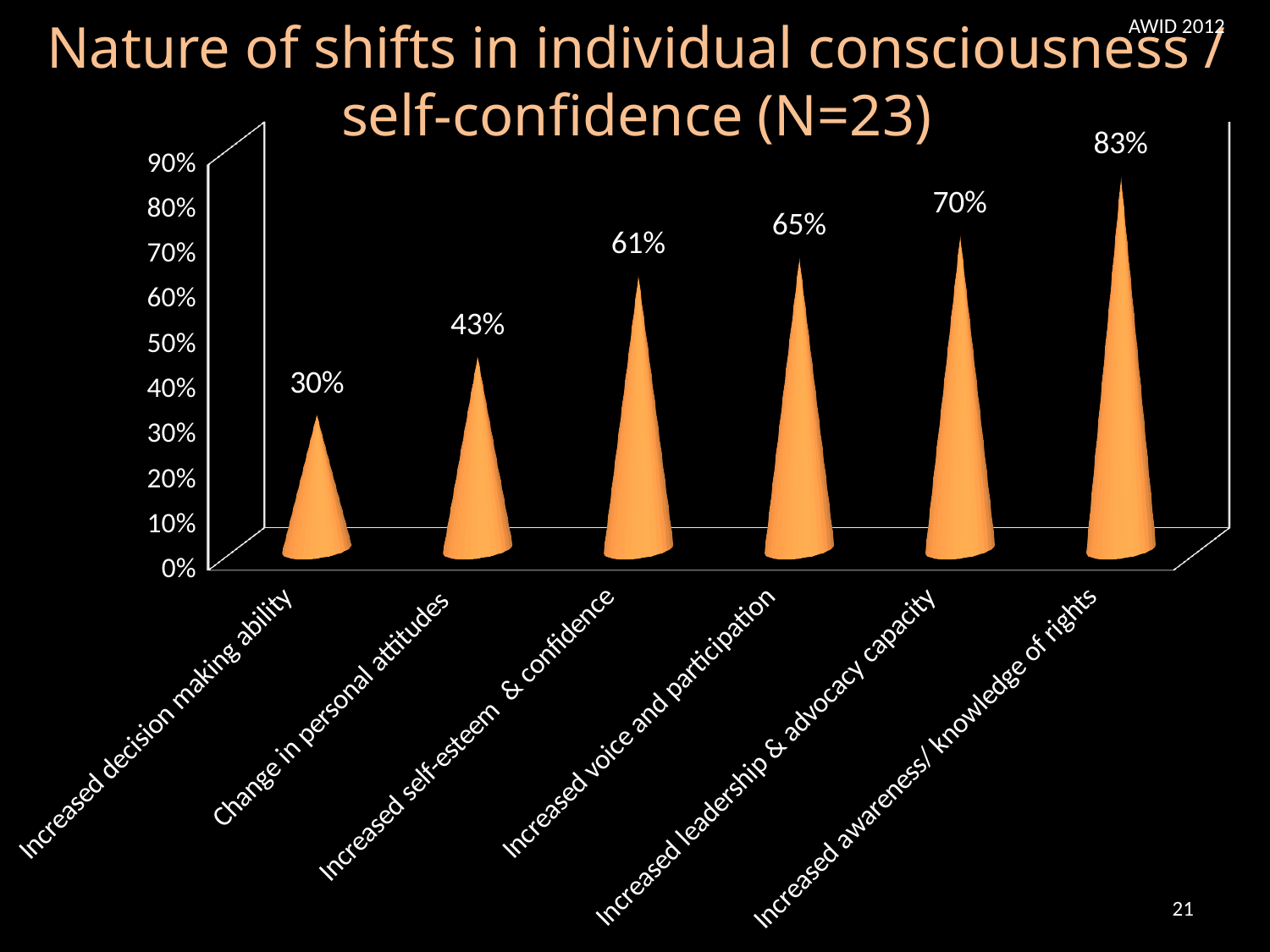
What is the difference between the values for Increased self-esteem & confidence and Change in personal attitudes? 18% Is the value for Increased self-esteem & confidence greater or less than 50%? greater Which category has the highest value? Increased awareness/ knowledge of rights How many categories are shown in the chart? 6 Which category has the lowest value? Increased decision making ability What is the value for Increased decision making ability? 30% What kind of chart is shown on the slide? bar chart What is the value for Increased leadership & advocacy capacity? 70% What is the difference between the values for Increased awareness/ knowledge of rights and Increased decision making ability? 53% Do the values rise or fall from left to right along the x axis? rise What is the value for Increased voice and participation? 65% Which is larger, the value for Change in personal attitudes or the value for Increased voice and participation? Increased voice and participation